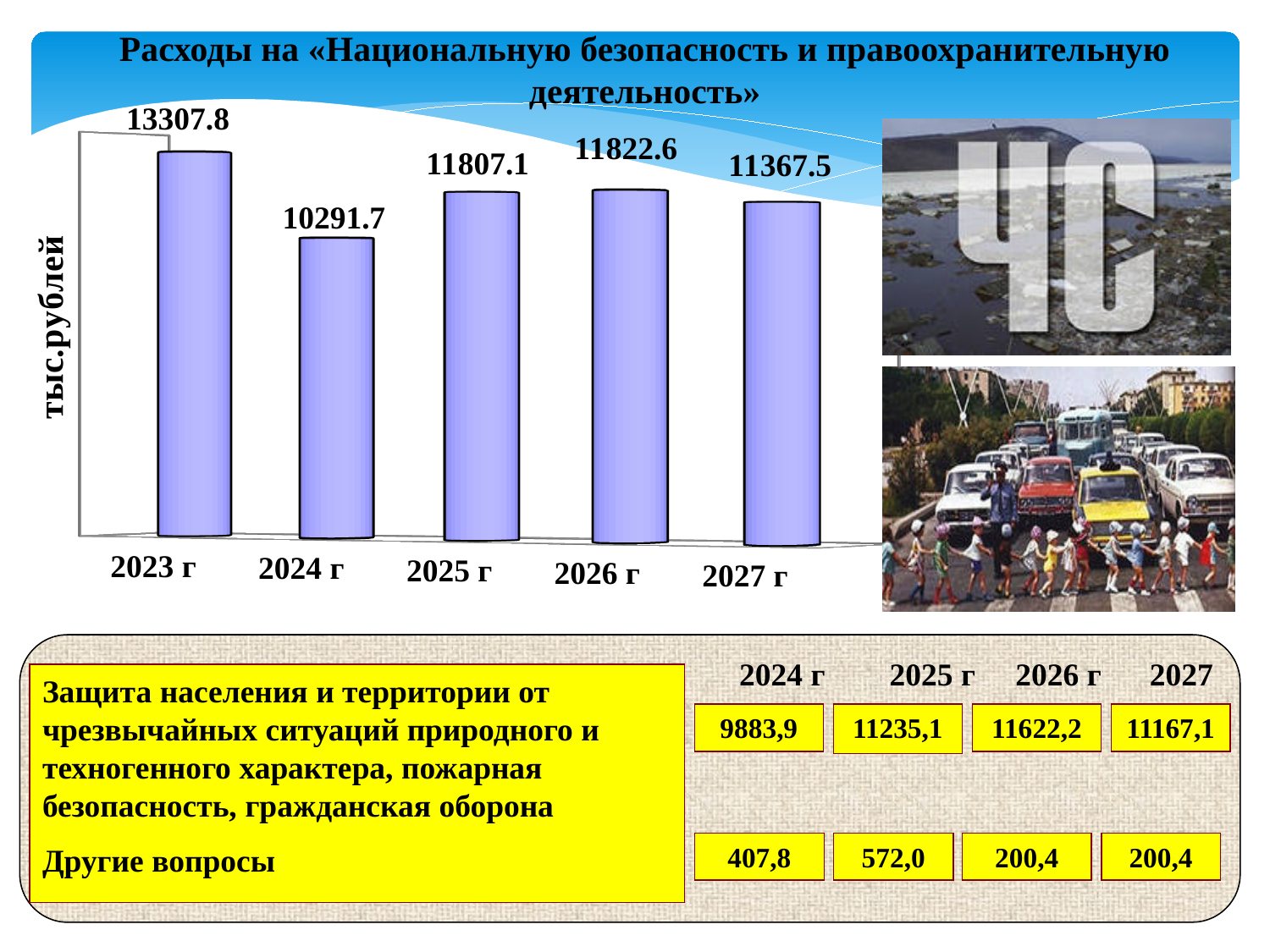
Which year has the lowest value? 2024 г Which year has the highest value? 2023 г What unit is shown on the vertical axis label of the chart? тыс.рублей What is the value for 2026 г? 11822.6 What is the difference between the values for 2026 г and 2027 г? 455.1 What is the value for 2027 г? 11367.5 What kind of chart is shown? bar chart Which is larger, the value for 2025 г or the value for 2027 г? 2025 г What is the difference between the values for 2023 г and 2024 г? 3016.1 What is the value for 2023 г? 13307.8 How many years are shown in the chart? 5 What is the value for 2024 г? 10291.7